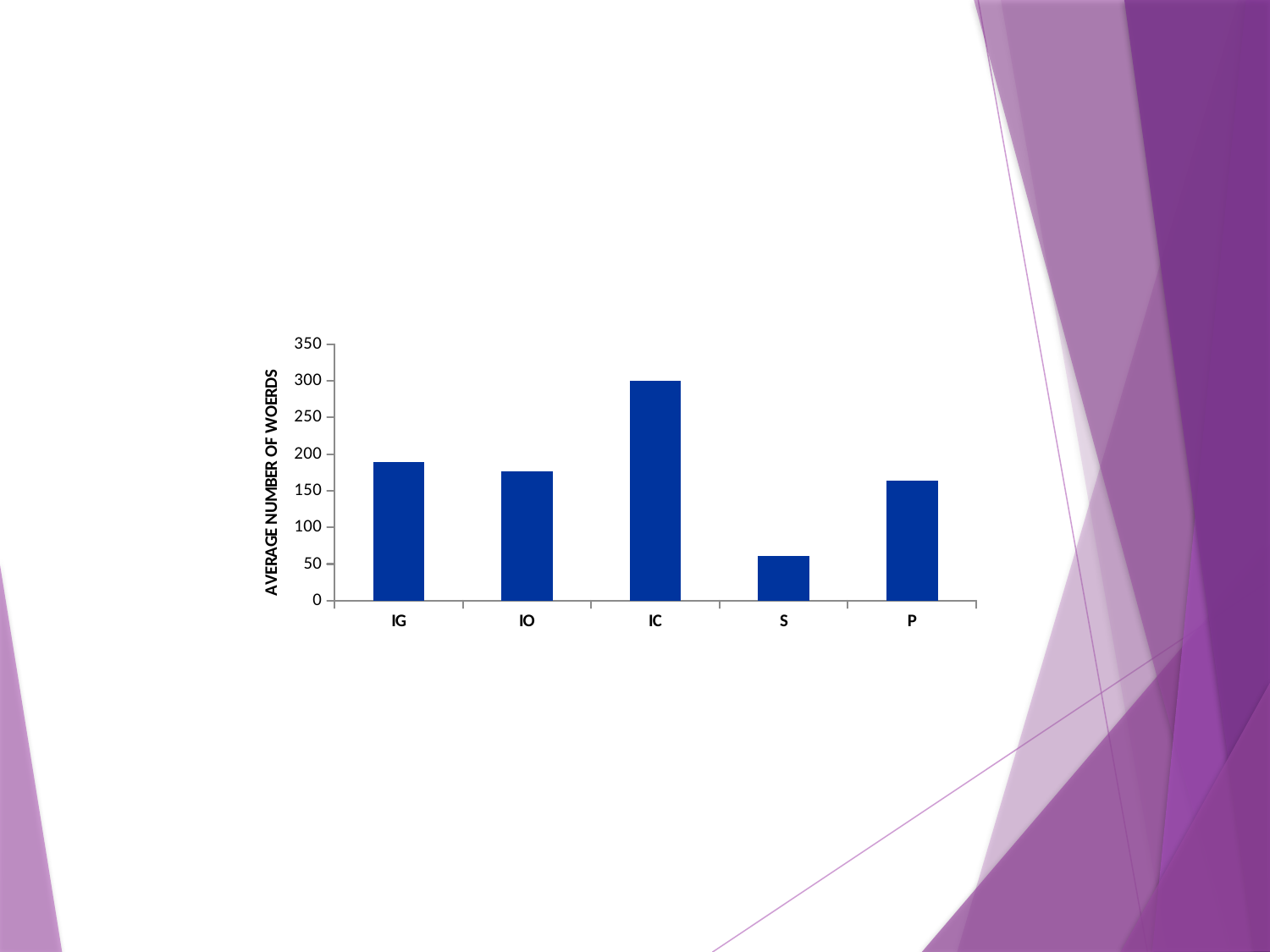
What colour are the bars in the chart? blue What kind of chart is shown on the slide? bar chart What is the label on the vertical axis of the chart? AVERAGE NUMBER OF WOERDS Which has a higher value, IG or P? IG How many categories are shown on the x axis of the chart? 5 Which has a higher value, IC or IO? IC Is the value for IO greater or less than 200? less Is the value for IG greater or less than 150? greater Is the value for S greater or less than 100? less Which category has the lowest average number of words? S Which category has the highest average number of words? IC